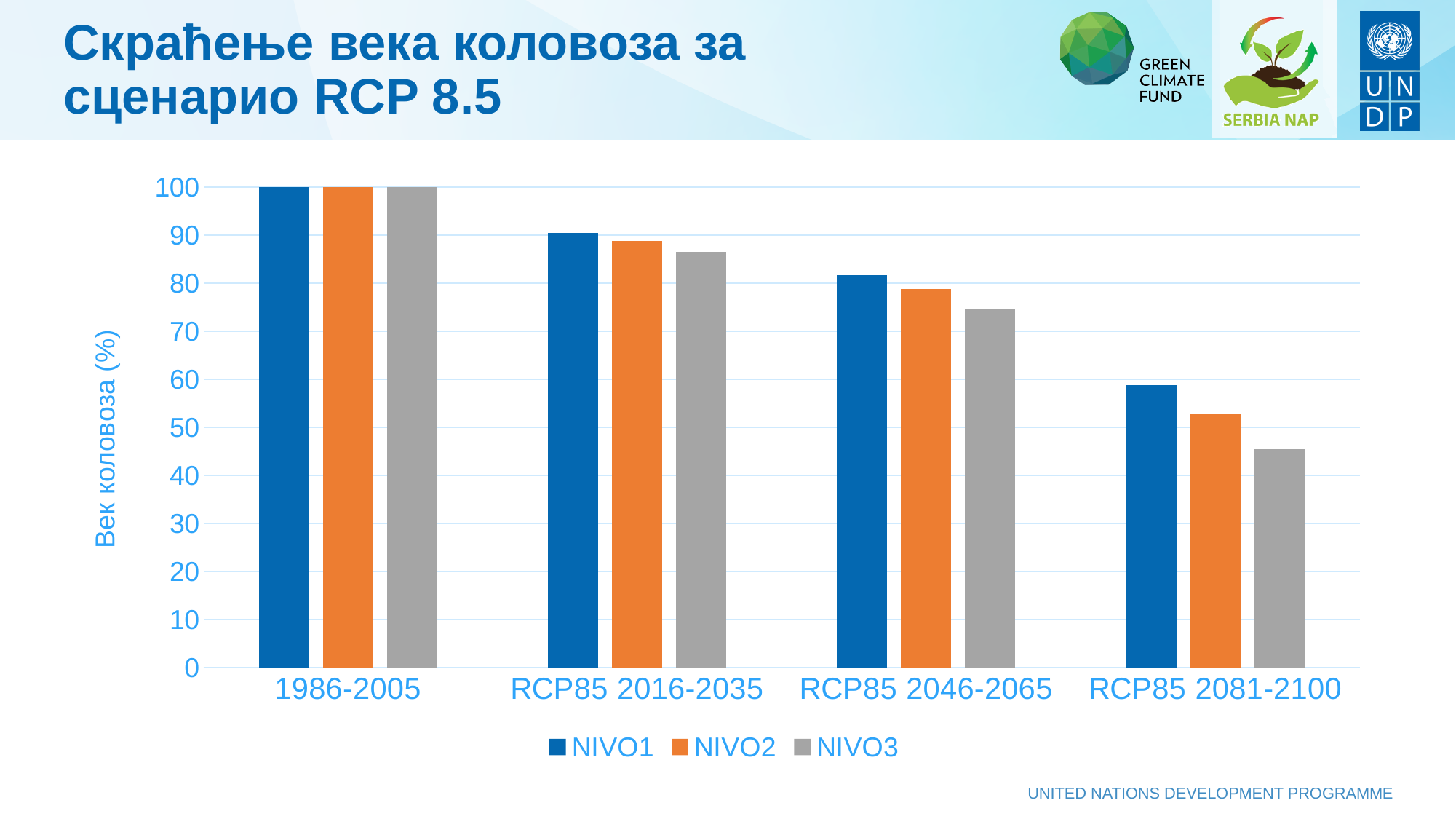
Which category has the lowest NIVO3 value? RCP85 2081-2100 How many series does the legend list? 3 Is the value for NIVO3 in RCP85 2046-2065 greater or less than 70? greater Which series has the highest value in the RCP85 2081-2100 category? NIVO1 Do the NIVO2 values rise or fall from left to right along the x axis? fall What is the value for NIVO1 in the 1986-2005 category? 100 Which is larger in the RCP85 2046-2065 category, NIVO1 or NIVO3? NIVO1 What is the title of the y axis? Век коловоза (%) Is the value for NIVO3 in RCP85 2081-2100 greater or less than 50? less What is the value for NIVO3 in the 1986-2005 category? 100 How many categories are shown on the x axis? 4 What kind of chart is shown on the slide? bar chart